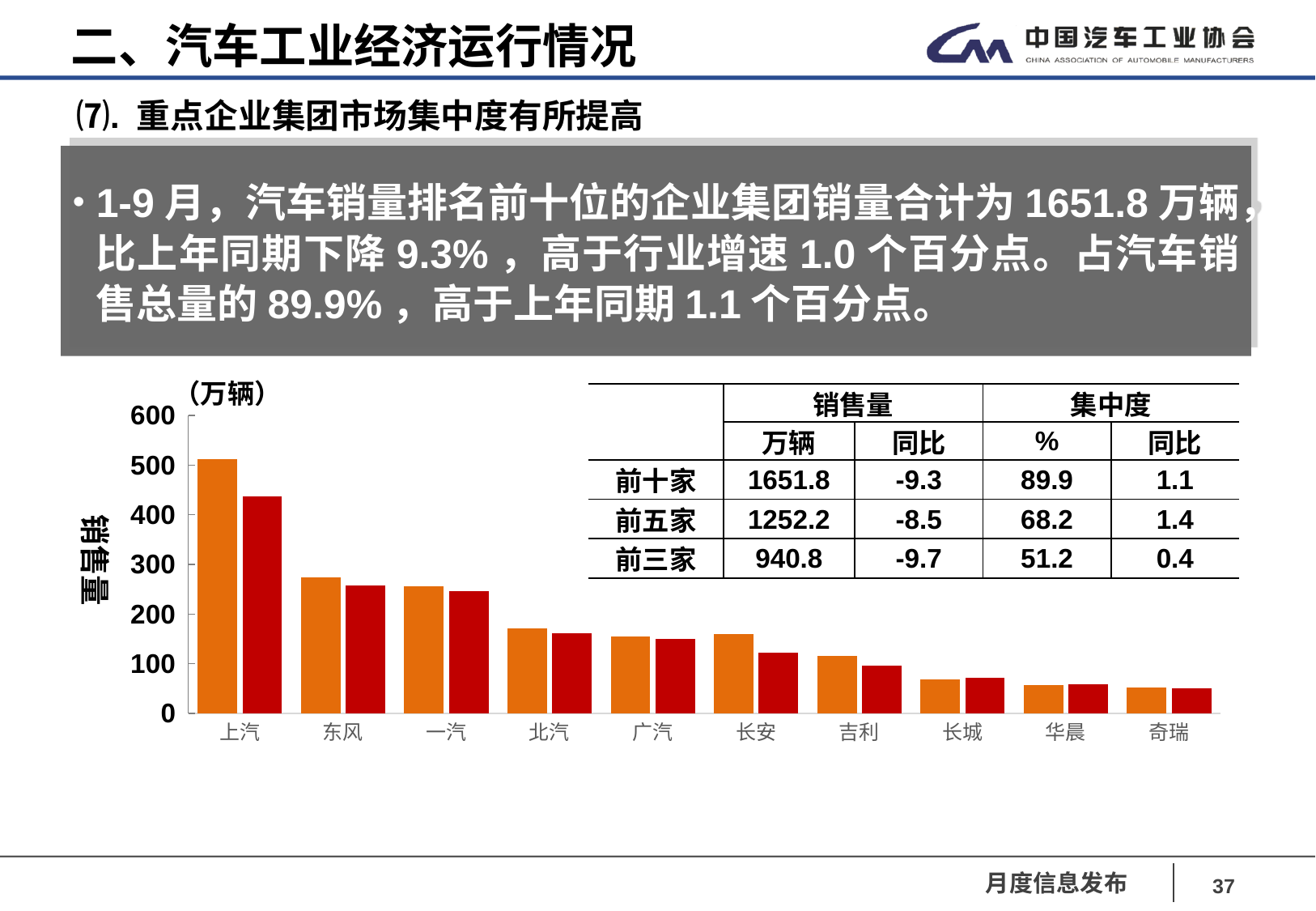
Is the orange bar for 上汽 greater or less than 400? greater Which company group has the highest sales in the bar chart? 上汽 How many company groups are shown on the x axis of the bar chart? 10 What is the y-axis title of the bar chart? 销售量 What kind of chart is shown on the slide? bar chart Is the orange bar for 东风 greater or less than 300? less Is the orange bar for 长城 greater or less than 100? less Which has the larger orange bar, 上汽 or 东风? 上汽 Do the bar values rise or fall moving from left to right along the x axis? fall Which has the larger orange bar, 长安 or 吉利? 长安 What unit is shown above the y axis of the bar chart? 万辆